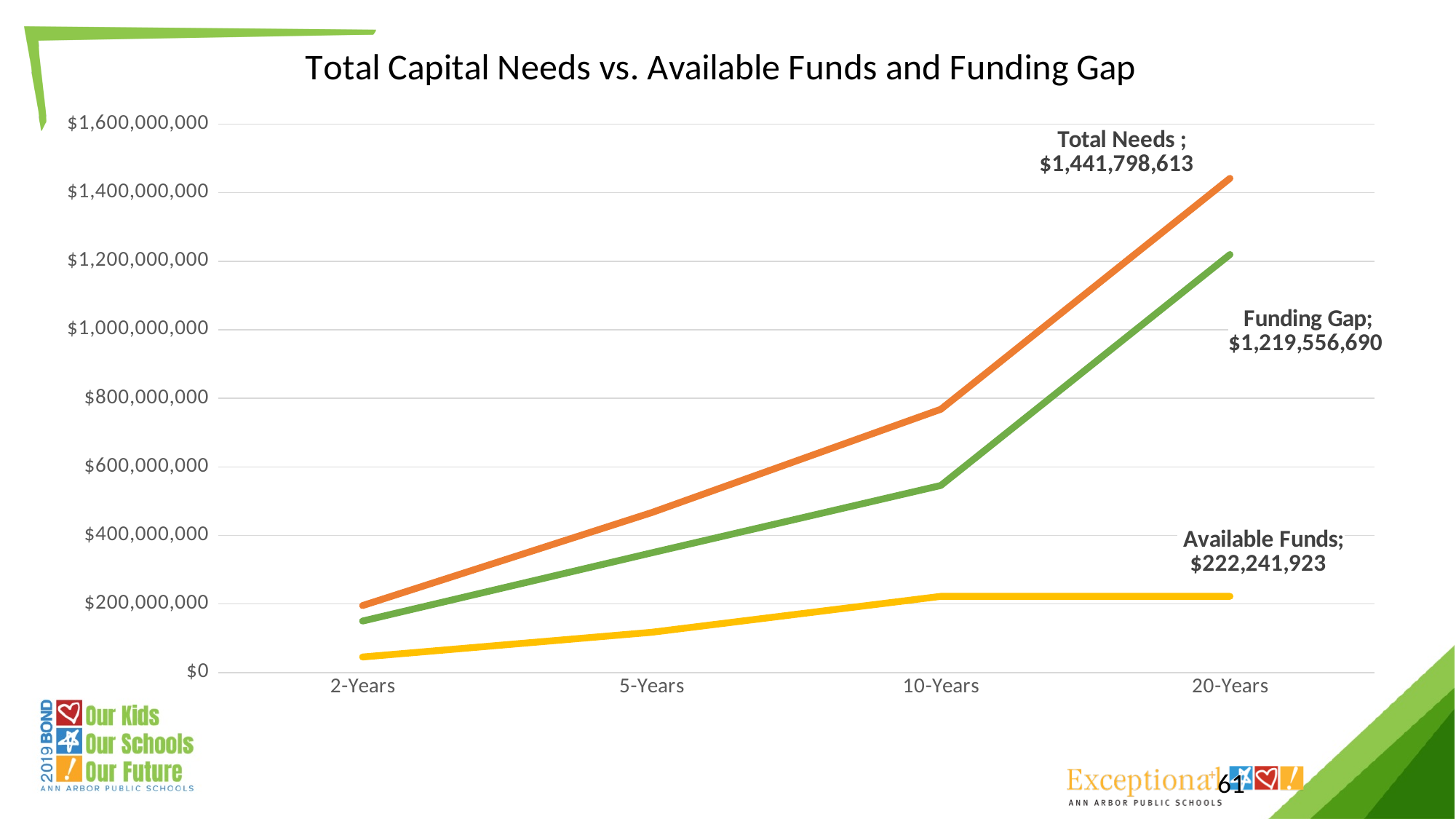
What is the value of the Funding Gap at 20-Years? $1,219,556,690 Which series has the highest value at 20-Years? Total Needs What kind of chart is shown on the slide? line chart What is the value of Available Funds at 20-Years? $222,241,923 Does the Total Needs line rise or fall from 2-Years to 20-Years? rise How many data series are plotted on the chart? 3 How many time periods are shown on the x axis? 4 Is the value for Total Needs at 10-Years greater or less than $600,000,000? greater Which series has the lowest value at 20-Years? Available Funds What is the difference between Total Needs and the Funding Gap at 20-Years? $222,241,923 What is the title of the chart? Total Capital Needs vs. Available Funds and Funding Gap What is the value of Total Needs at 20-Years? $1,441,798,613